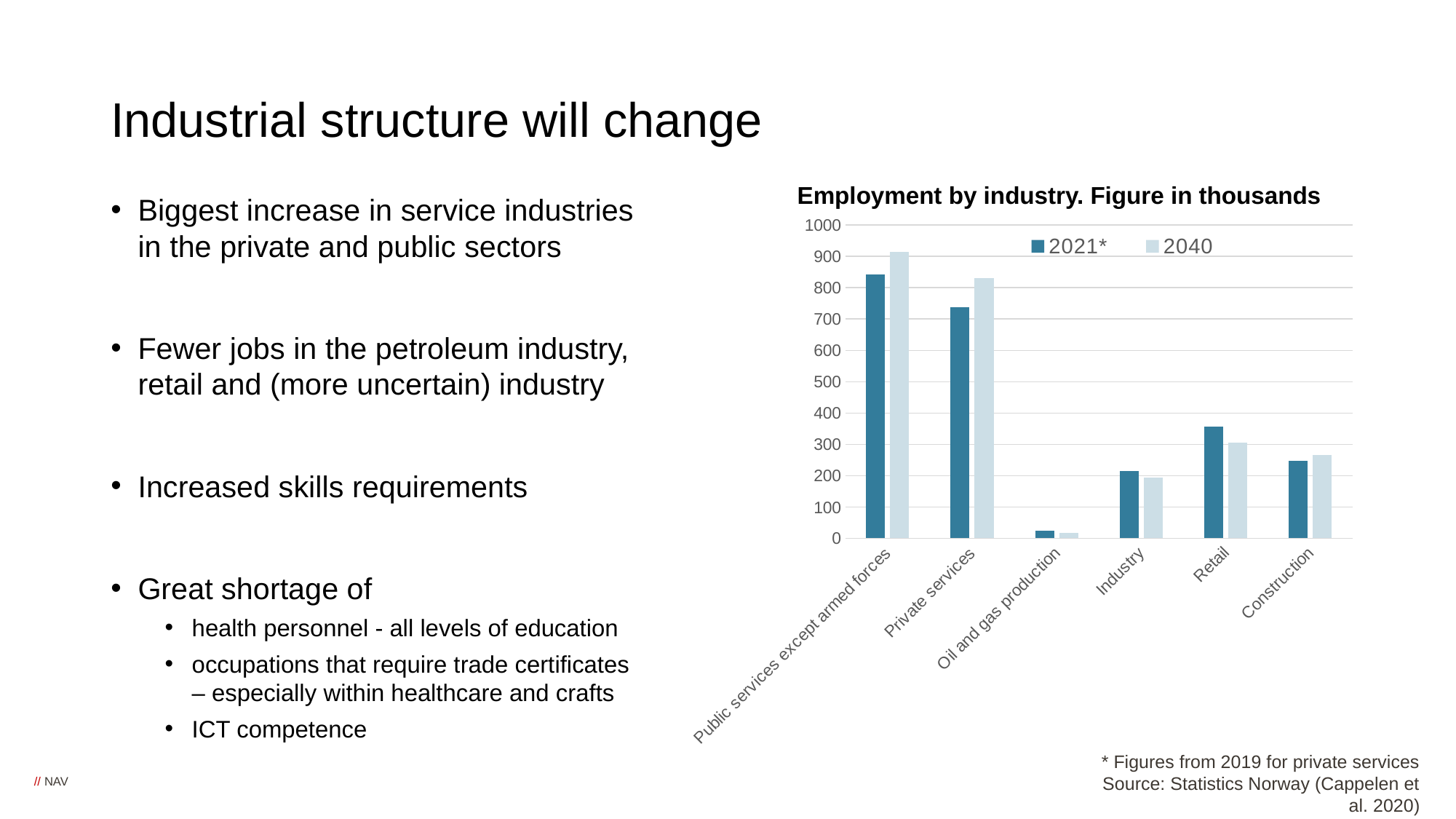
Which industry has the highest 2040 value in the chart? Public services except armed forces Which industry has the lowest 2021* value in the chart? Oil and gas production How many industry categories are shown on the x axis of the chart? 6 For Retail, which series is larger: 2021* or 2040? 2021* Is the 2021* value for Retail greater or less than 300? greater What is the title of the chart? Employment by industry. Figure in thousands What are the two entries in the chart's legend? 2021* and 2040 For Private services, which series is larger: 2021* or 2040? 2040 Is the 2021* value for Private services greater or less than 800? less What kind of chart is shown on the slide? Bar chart Is the 2040 value for Public services except armed forces greater or less than 800? greater How many series does the legend of the chart list? 2